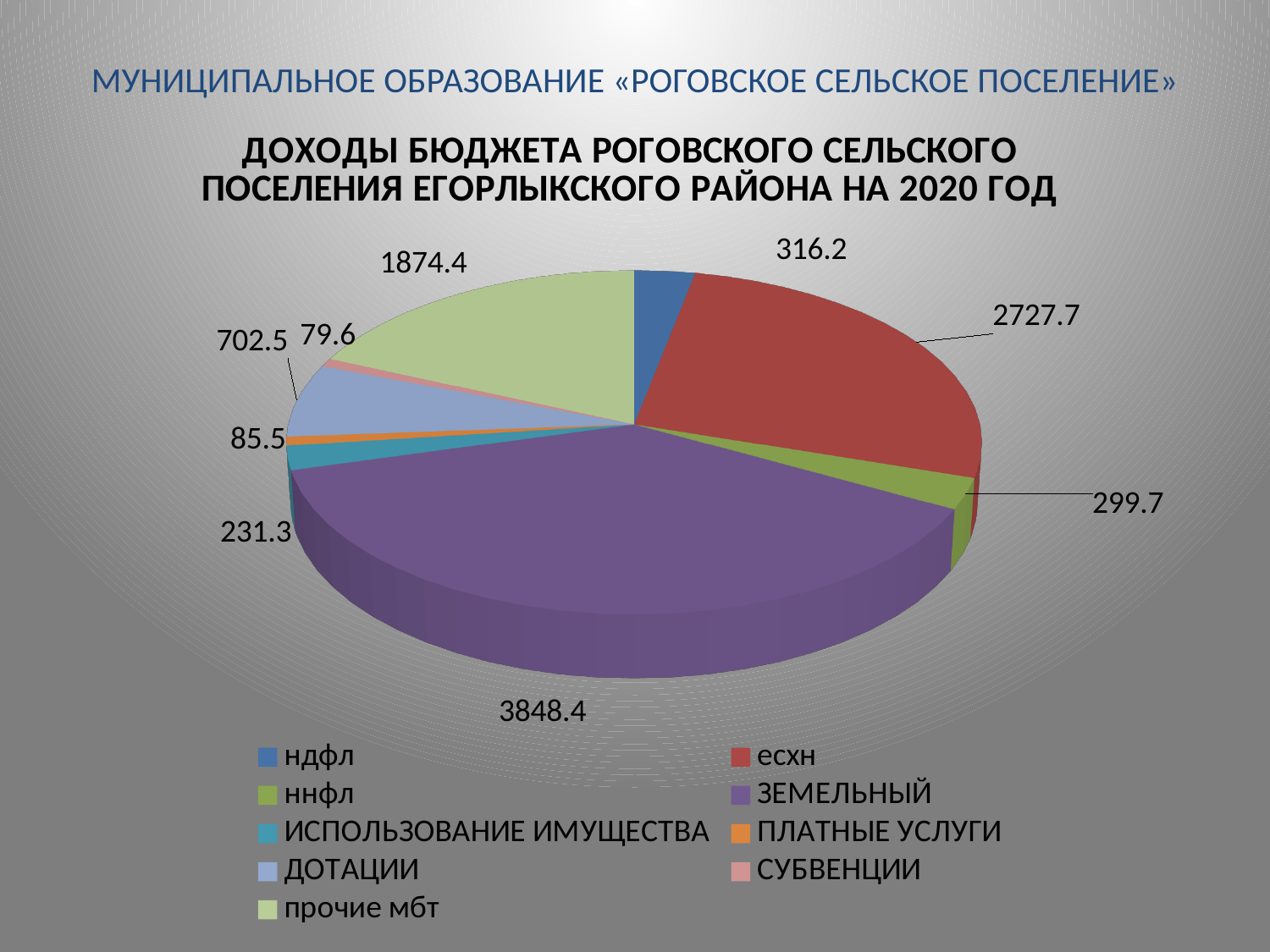
What is the value for есхн? 2727.7 What colour is the slice for ЗЕМЕЛЬНЫЙ? purple Which category has the smallest slice? СУБВЕНЦИИ What is the value for ДОТАЦИИ? 702.5 What is the total of all slices in the pie chart? 10165.3 What is the value for прочие мбт? 1874.4 What type of chart is shown on the slide? pie chart How many categories does the legend list? 9 What is the value for ЗЕМЕЛЬНЫЙ? 3848.4 Which category has the largest slice? ЗЕМЕЛЬНЫЙ Which is larger, ндфл or ннфл? ндфл What is the difference between the values for есхн and ндфл? 2411.5